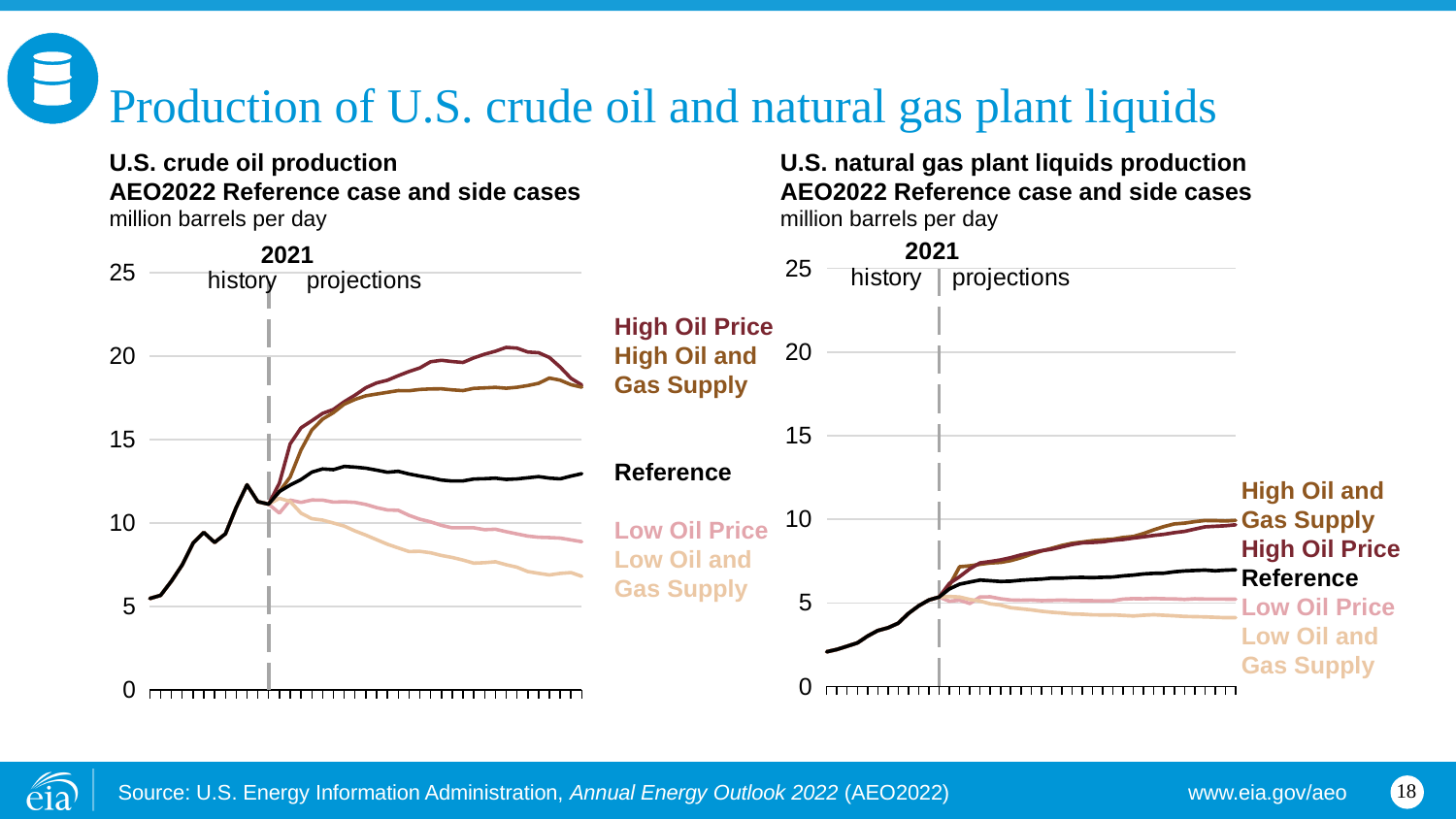
In the U.S. crude oil production chart, does the Low Oil and Gas Supply case rise or fall over the projection period? fall In the U.S. natural gas plant liquids production chart, does the Reference case rise or fall over the projection period? rise In the U.S. natural gas plant liquids production chart, is the Reference case value at the end of the projection period greater or less than 5? greater What unit of measurement is used on both charts? million barrels per day In the U.S. crude oil production chart, is the peak value of the High Oil Price case greater or less than 20? greater In the U.S. crude oil production chart, is the Reference case value at the end of the projection period greater or less than 15? less In the U.S. natural gas plant liquids production chart, which case has the lowest production at the end of the projection period? Low Oil and Gas Supply In the U.S. crude oil production chart, which case has the lowest production at the end of the projection period? Low Oil and Gas Supply What type of chart is used for U.S. crude oil production on the left of the slide? line chart How many series (cases) are shown in the U.S. crude oil production chart? 5 In the U.S. crude oil production chart, which case reaches the highest production level during the projection period? High Oil Price How many series (cases) are shown in the U.S. natural gas plant liquids production chart? 5